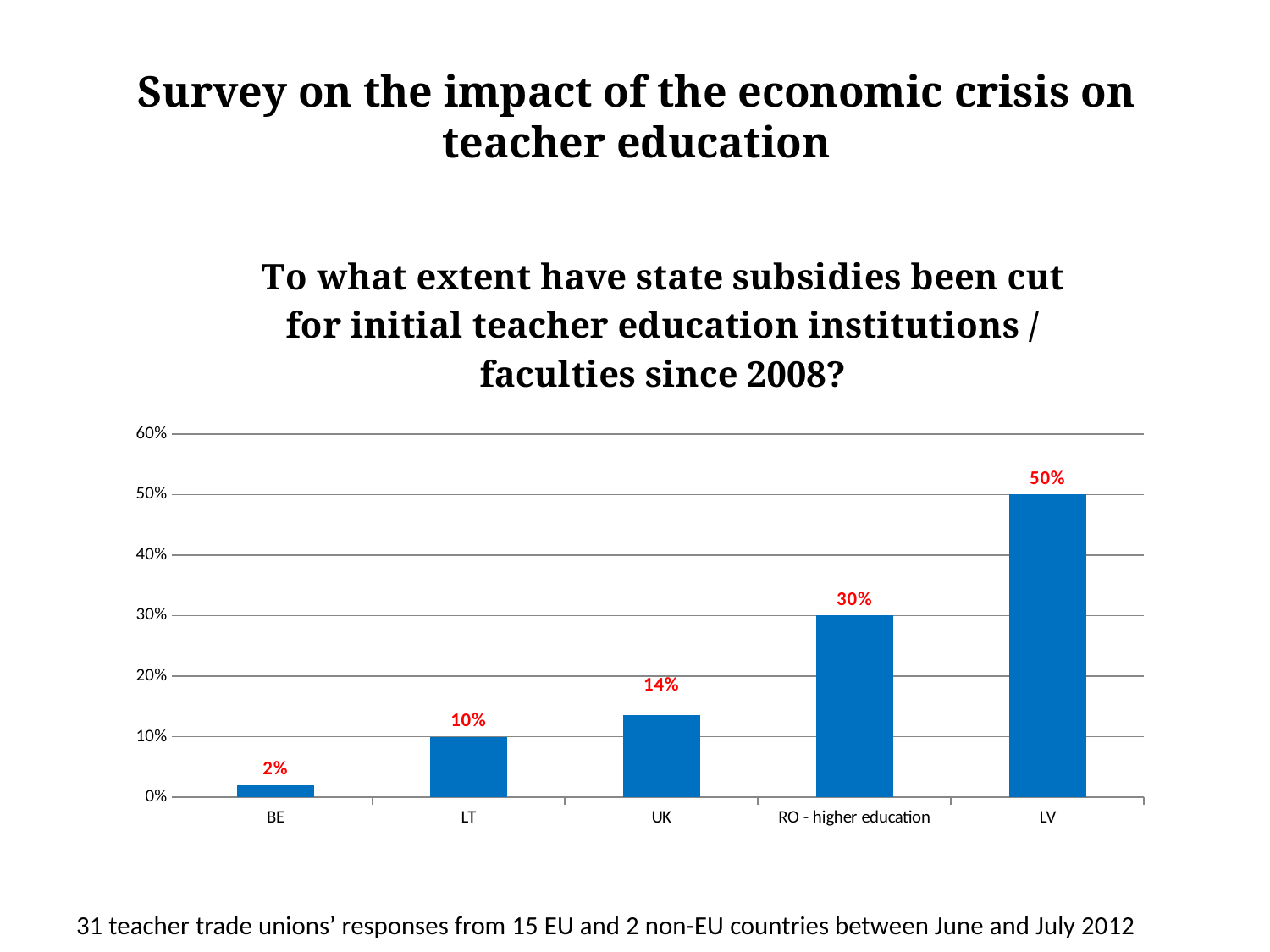
What is the value for LT? 10% What kind of chart is shown on the slide? bar chart How many categories are shown on the x axis? 5 What is the value for RO - higher education? 30% What is the difference between the values for LV and RO - higher education? 20% What is the value for BE? 2% What is the difference between the values for UK and LT? 4% Which category has the highest value? LV Which is larger, the value for UK or the value for LT? UK Which category has the lowest value? BE Do the values rise or fall from left to right along the x axis? rise Is the value for RO - higher education greater or less than 40%? less